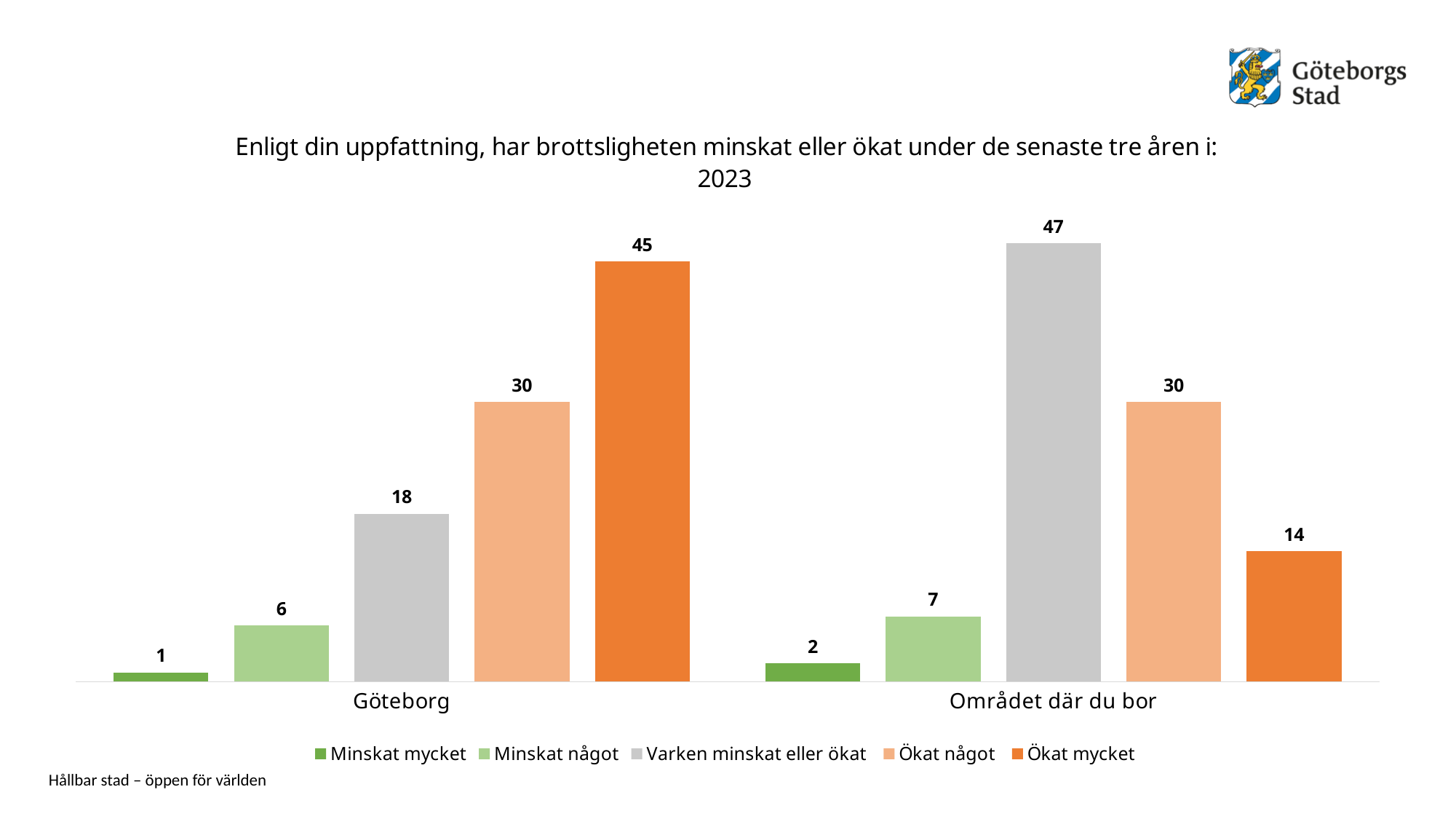
What kind of chart is shown on the slide? Bar chart What is the value for "Minskat mycket" in the Göteborg category? 1 Which series has the lowest value in the Göteborg category? Minskat mycket Which is larger: "Varken minskat eller ökat" for Göteborg or for "Området där du bor"? Området där du bor What is the value for "Ökat mycket" in the Göteborg category? 45 What is the value for "Minskat något" in the "Området där du bor" category? 7 Which series has the highest value in the "Området där du bor" category? Varken minskat eller ökat How many series does the legend list? 5 How many categories are shown on the x axis? 2 What is the value for "Varken minskat eller ökat" in the "Området där du bor" category? 47 What year is shown in the chart title? 2023 What is the difference between "Ökat mycket" for Göteborg and "Ökat mycket" for "Området där du bor"? 31